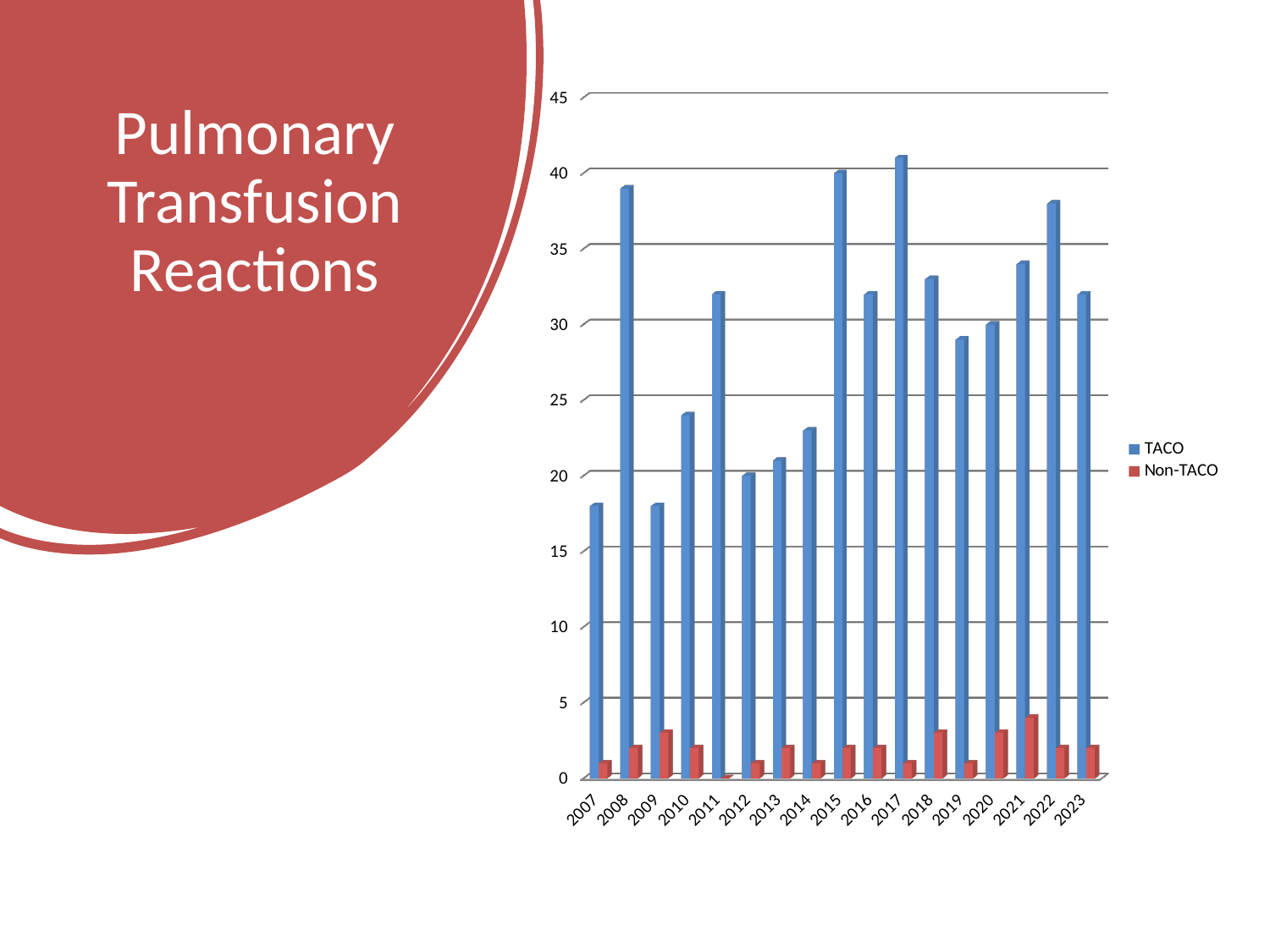
Which colour represents the TACO series in the legend? blue What kind of chart is shown on the slide? bar chart Is the TACO value for 2012 greater or less than 25? less Which year has the larger TACO value, 2020 or 2021? 2021 Do the TACO values rise or fall from 2012 to 2015? rise Which year has the highest Non-TACO value? 2021 Which year has the lowest Non-TACO value? 2011 Is the TACO value for 2022 greater or less than 35? greater Which year has the larger TACO value, 2008 or 2009? 2008 How many series does the legend list? 2 Is the TACO value for 2008 greater or less than 35? greater How many years are shown along the x axis? 17